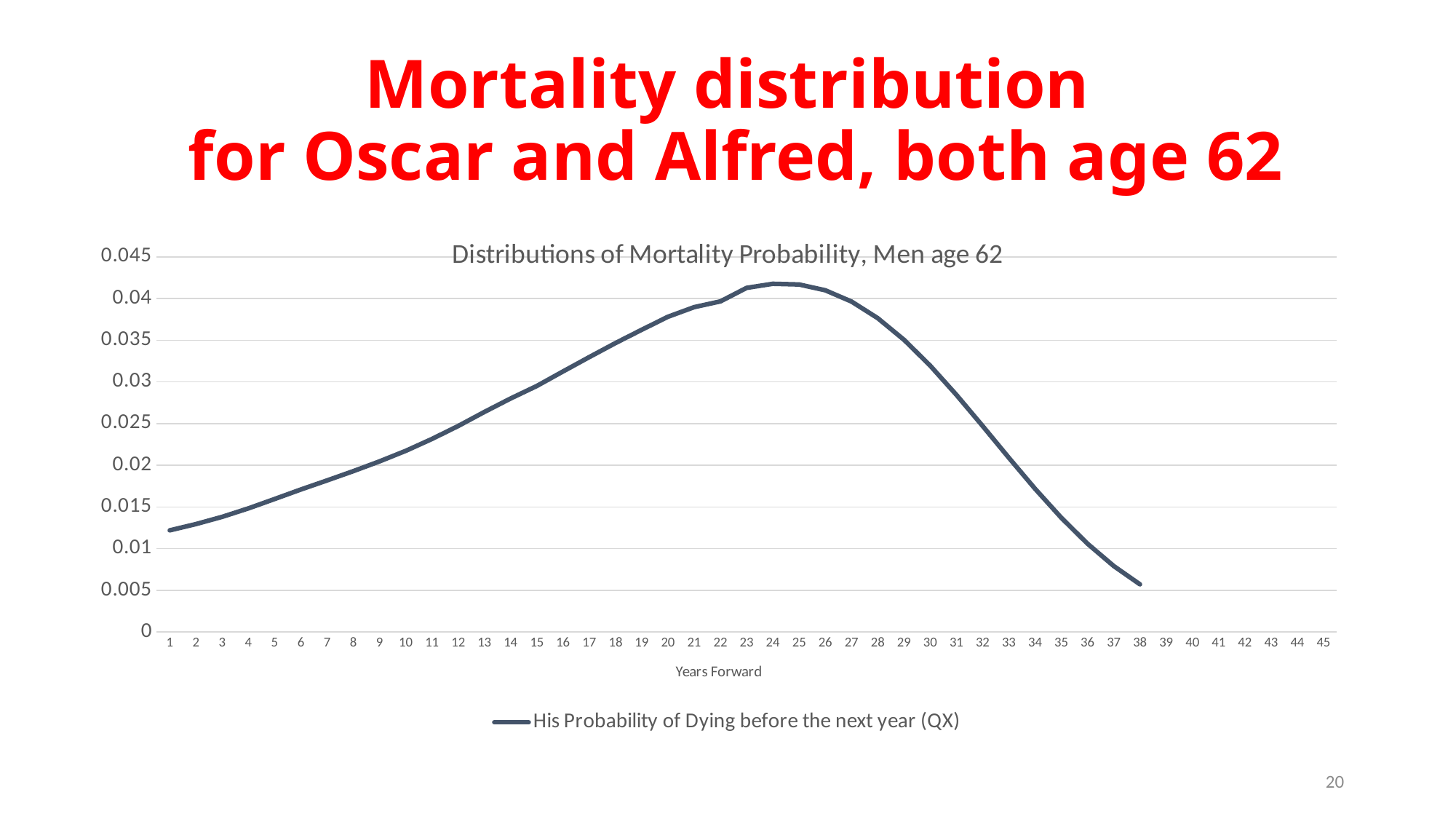
How many years forward are labelled on the x axis? 45 Is the value for year 38 greater or less than 0.01? less Is the value for year 1 greater or less than 0.015? less What is the title of the chart? Distributions of Mortality Probability, Men age 62 Is the value for year 24 greater or less than 0.04? greater What kind of chart is shown on the slide? line chart Which has the larger value, year 10 or year 30? year 30 Does the probability rise or fall from year 1 to year 20? rise How many series does the legend list? 1 What is the label of the x axis? Years Forward